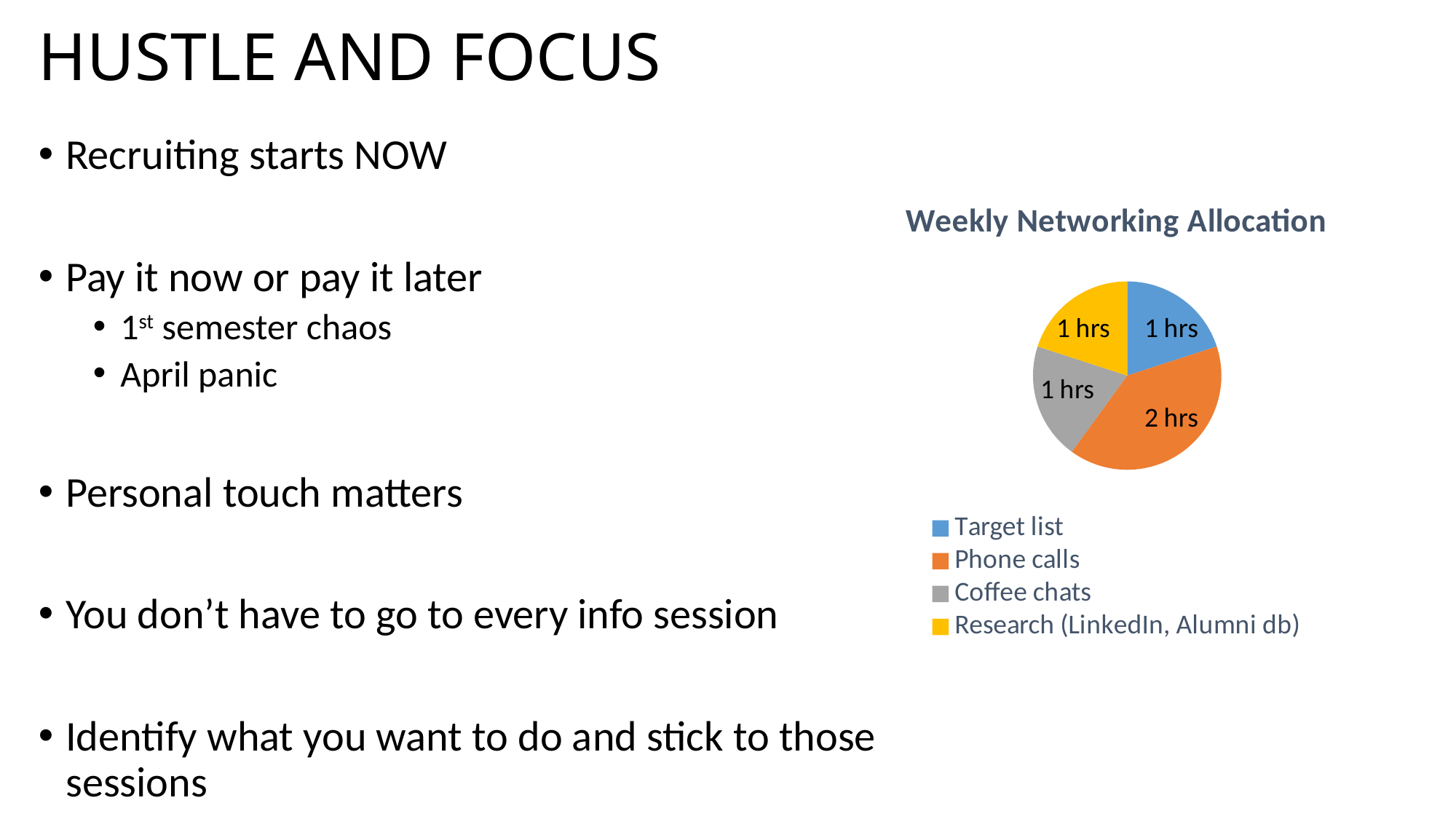
How many hours per week are allocated to Coffee chats? 1 hrs How many hours per week are allocated to Target list? 1 hrs What kind of chart is shown on the slide? Pie chart What is the title of the chart? Weekly Networking Allocation How many hours per week are allocated to Phone calls? 2 hrs How many categories does the pie chart show? 4 Which colour represents Research (LinkedIn, Alumni db) in the pie chart? Yellow What share of the total weekly networking time is allocated to Phone calls? 40% How many more hours are allocated to Phone calls than to Coffee chats? 1 hrs Which category has the largest allocation in the pie chart? Phone calls How many hours per week are allocated to Research (LinkedIn, Alumni db)? 1 hrs What is the total number of hours shown across all slices of the pie chart? 5 hrs